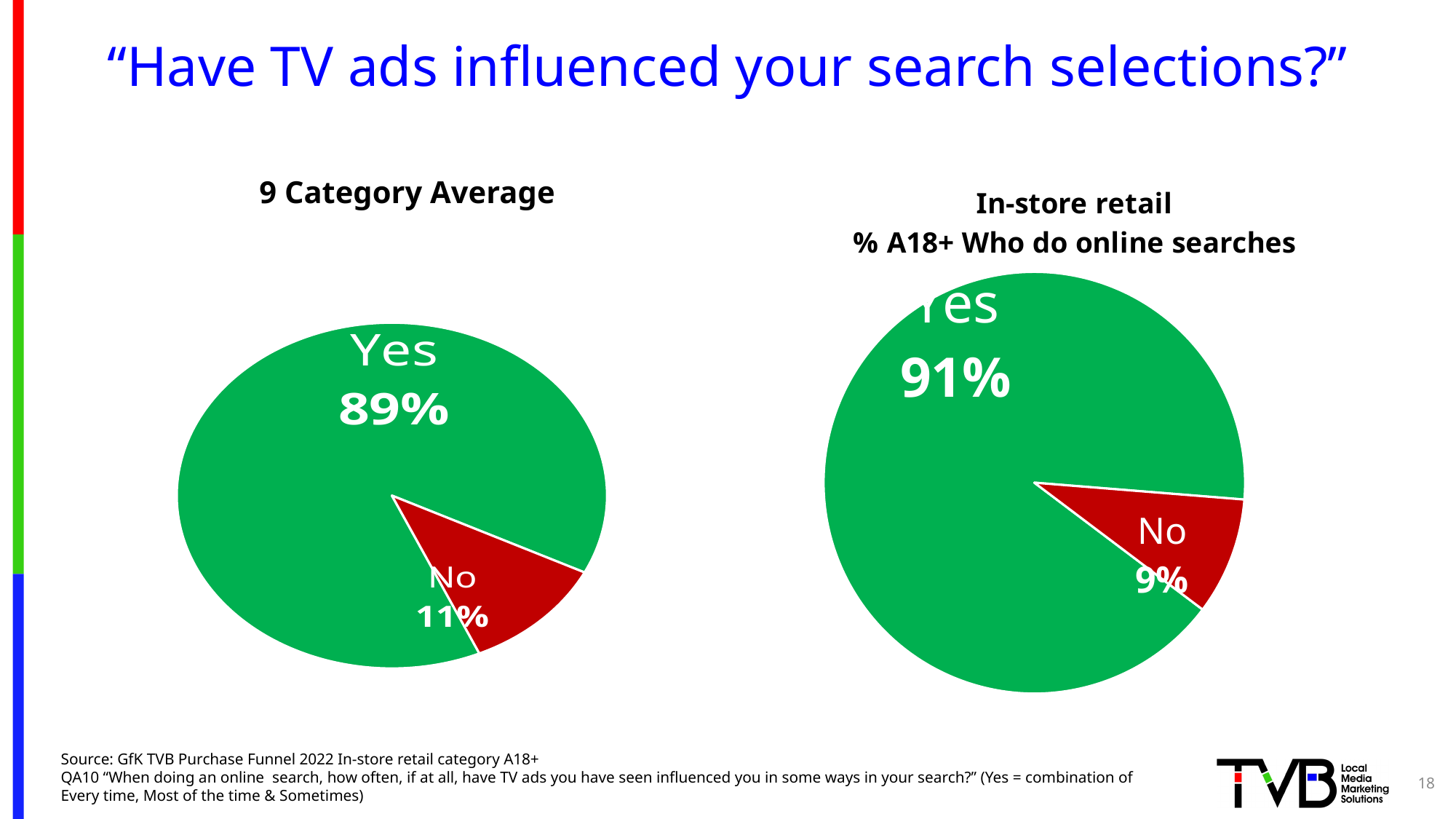
In the 9 Category Average chart, what is the difference between the Yes and No percentages? 78% Which chart has the larger Yes share, 9 Category Average or In-store retail? In-store retail In the In-store retail chart, what is the difference between the Yes and No percentages? 82% In the In-store retail chart, which slice is the smallest? No In the 9 Category Average chart, what percentage answered Yes? 89% In the In-store retail chart, what percentage answered No? 9% How many slices does the In-store retail pie chart have? 2 In the In-store retail chart, what percentage answered Yes? 91% In the 9 Category Average chart, what percentage answered No? 11% What type of chart is used on this slide? Pie chart In the 9 Category Average chart, what colour is the No slice? Red In the 9 Category Average chart, which slice is the largest? Yes